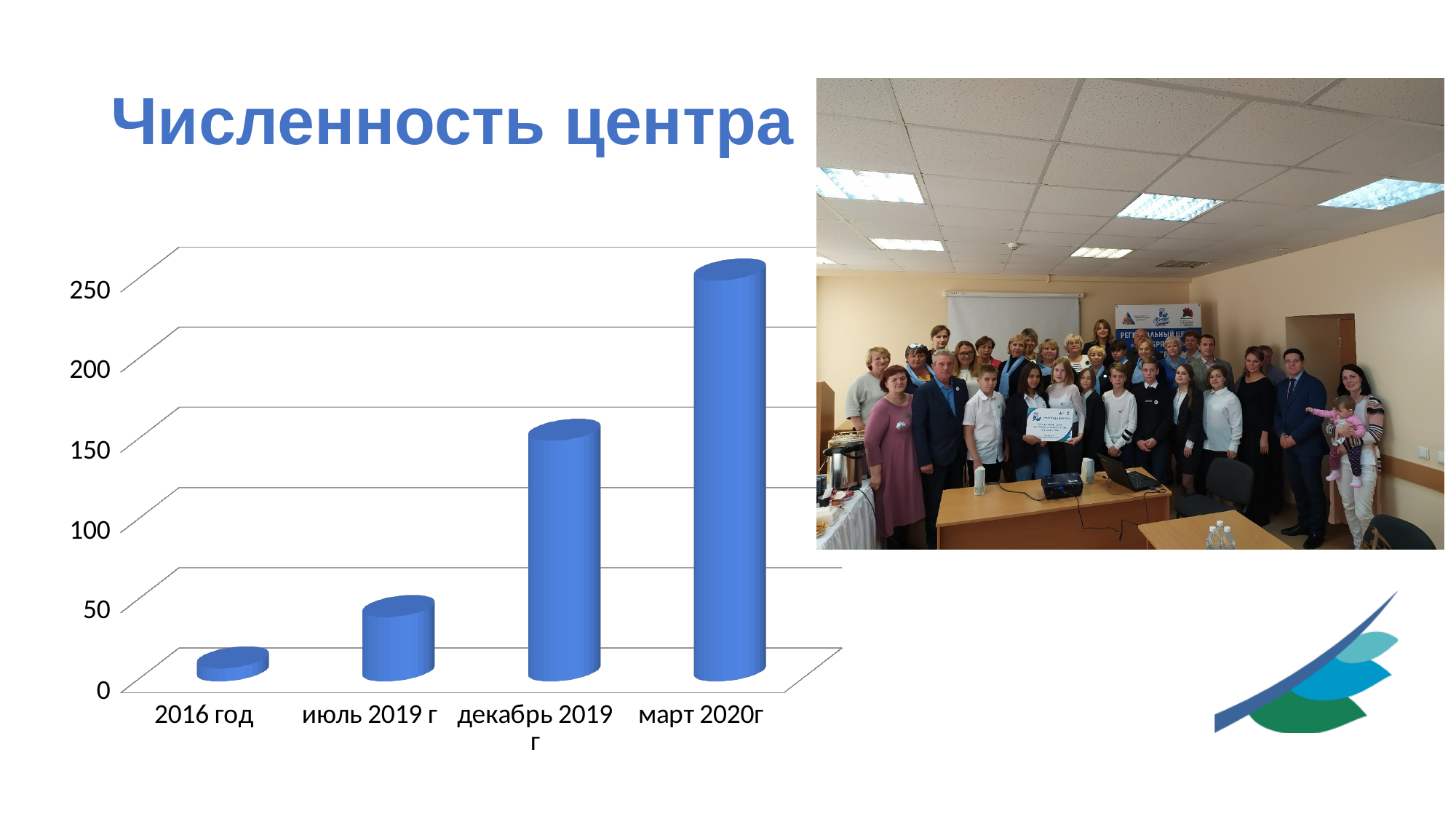
Is the value for март 2020г greater or less than 200? greater What kind of chart is shown on the slide? bar chart Which is larger, the value for декабрь 2019 г or the value for июль 2019 г? декабрь 2019 г Which is larger, the value for март 2020г or the value for 2016 год? март 2020г Is the value for декабрь 2019 г greater or less than 100? greater Is the value for 2016 год greater or less than 50? less Do the values rise or fall from 2016 год to март 2020г along the x axis? rise Which category has the lowest value in the chart? 2016 год Which category has the highest value in the chart? март 2020г What colour are the bars in the chart? blue How many categories are shown on the x axis of the chart? 4 What is the title of the chart? Численность центра